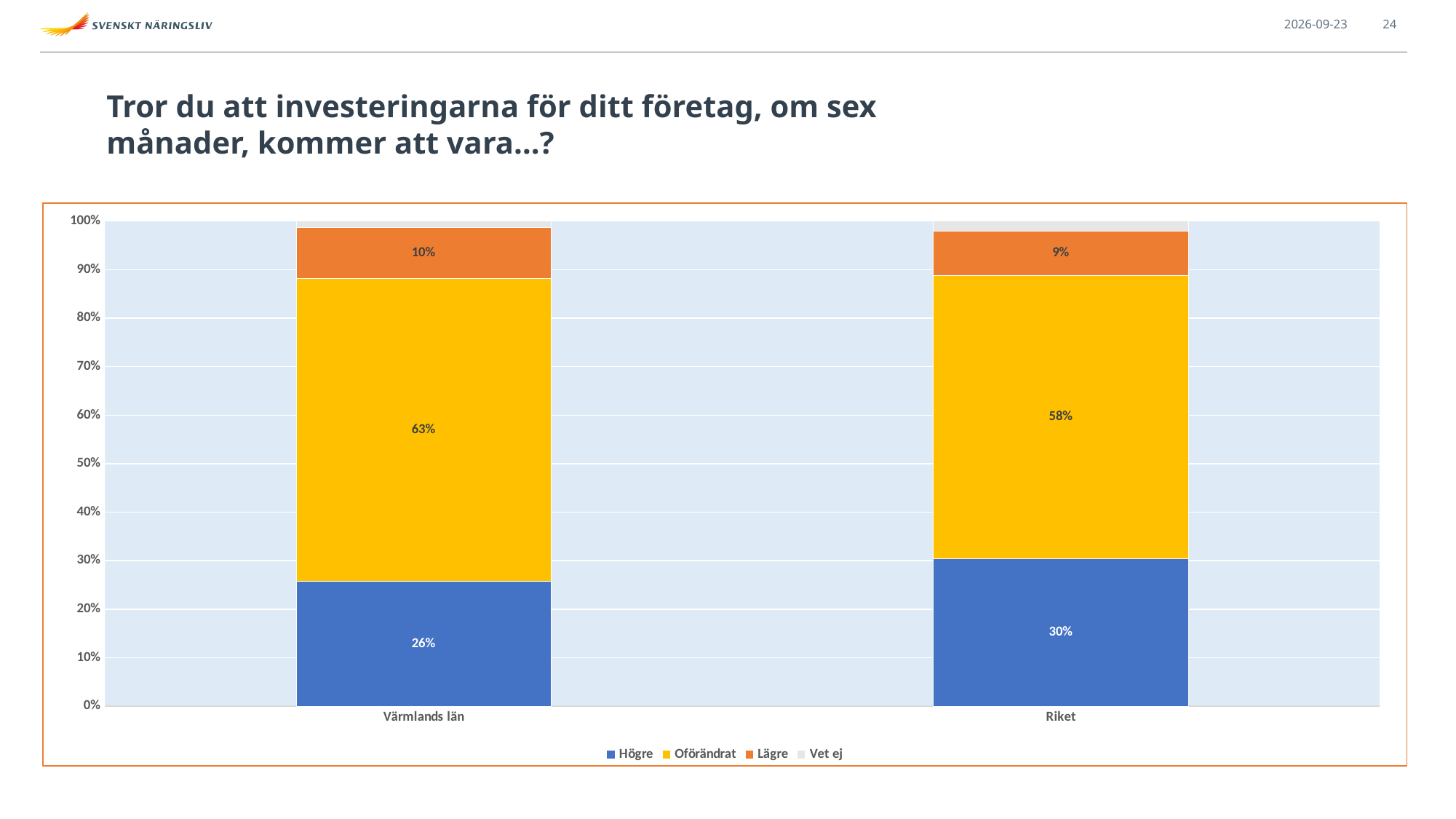
How many series does the legend list? 4 What is the difference between the Oförändrat values for Värmlands län and Riket? 5% What kind of chart is shown on the slide? Stacked bar chart Which category has the higher value for Oförändrat, Värmlands län or Riket? Värmlands län What is the difference between the Högre values for Riket and Värmlands län? 4% How many categories are shown on the x axis? 2 What is the value for Lägre for Värmlands län? 10% What is the value for Oförändrat for Värmlands län? 63% Which series is shown in yellow in the legend? Oförändrat What is the value for Oförändrat for Riket? 58% What is the value for Högre for Riket? 30% Which category has the higher value for Högre, Värmlands län or Riket? Riket